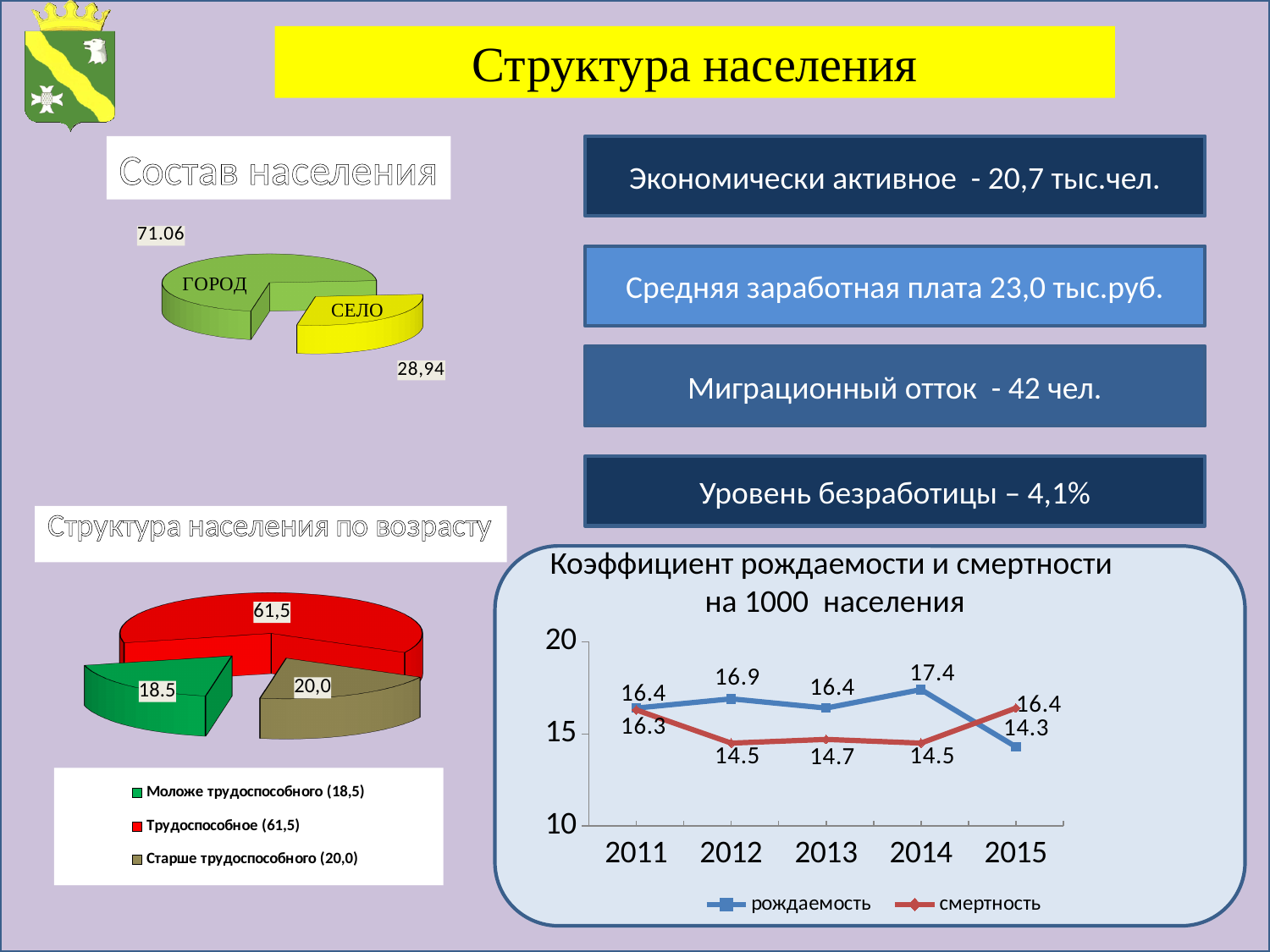
What type of chart is 'Коэффициент рождаемости и смертности на 1000 населения'? line chart In the 'Состав населения' pie chart, what is the value for ГОРОД? 71.06 In the 'Структура населения по возрасту' pie chart, how many categories are shown? 3 In the 'Коэффициент рождаемости и смертности на 1000 населения' chart, what is the value of смертность in 2012? 14.5 In the 'Коэффициент рождаемости и смертности на 1000 населения' chart, which is larger in 2015, рождаемость or смертность? смертность In the 'Коэффициент рождаемости и смертности на 1000 населения' chart, what is the difference between рождаемость and смертность in 2013? 1.7 In the 'Структура населения по возрасту' pie chart, what is the value for Трудоспособное? 61,5 In the 'Коэффициент рождаемости и смертности на 1000 населения' chart, what is the value of рождаемость in 2014? 17.4 In the 'Состав населения' pie chart, which slice is larger, ГОРОД or СЕЛО? ГОРОД In the 'Состав населения' pie chart, what is the value for СЕЛО? 28,94 In the 'Коэффициент рождаемости и смертности на 1000 населения' chart, in which year is рождаемость highest? 2014 In the 'Структура населения по возрасту' pie chart, which category has the smallest value? Моложе трудоспособного